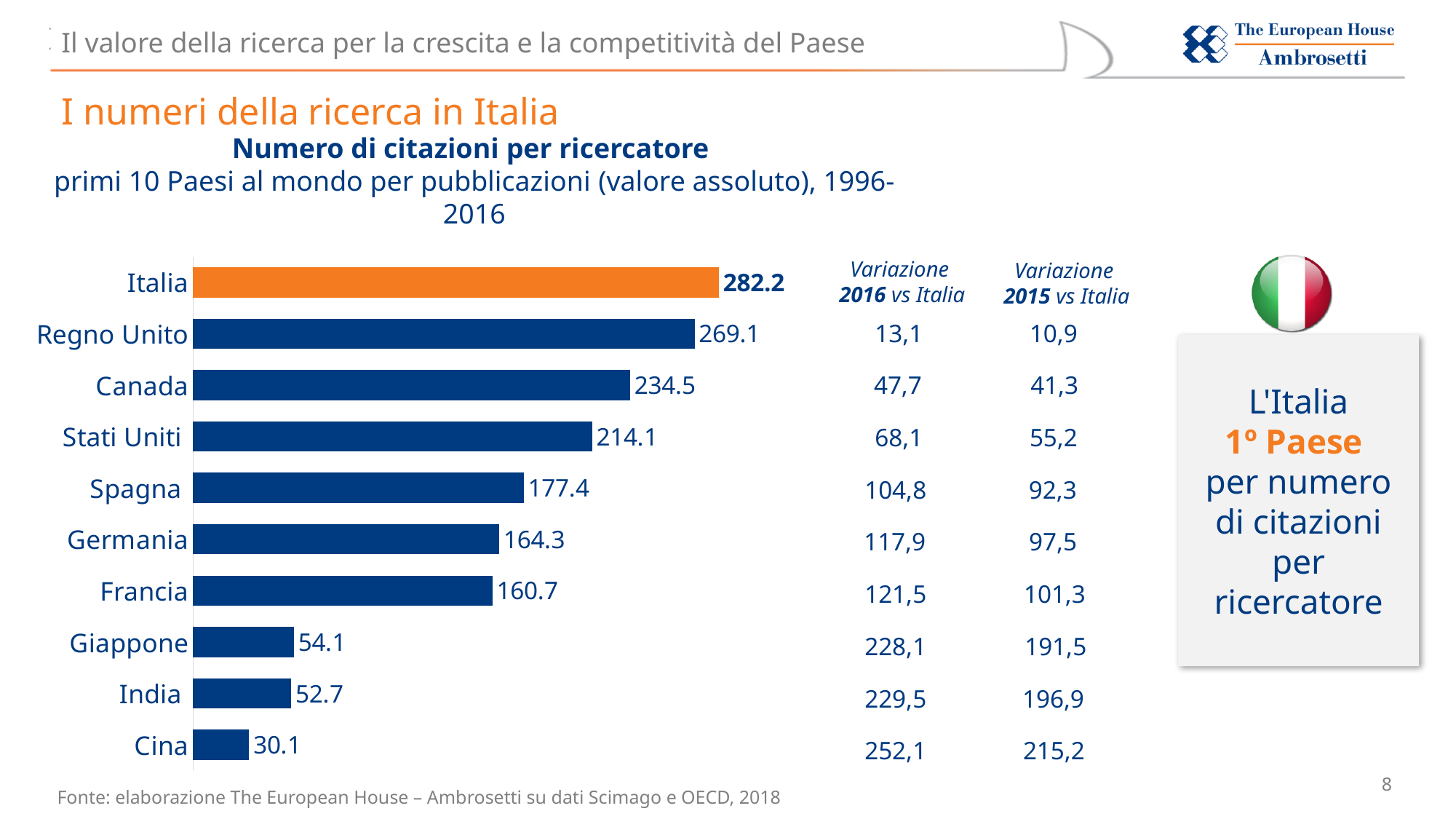
What is the difference between the values for Italia and Regno Unito? 13.1 What type of chart is used on this slide? Bar chart What is the number of citations per researcher for Italia? 282.2 What is the difference between the values for Spagna and Germania? 13.1 What is the value shown for Giappone? 54.1 Which country has the highest number of citations per researcher? Italia Which has a higher value, Francia or Germania? Germania Which has a higher value, Stati Uniti or Canada? Canada How many countries are shown in the chart? 10 What is the value shown for Canada? 234.5 Which bar is highlighted in orange? Italia Which country has the lowest number of citations per researcher? Cina